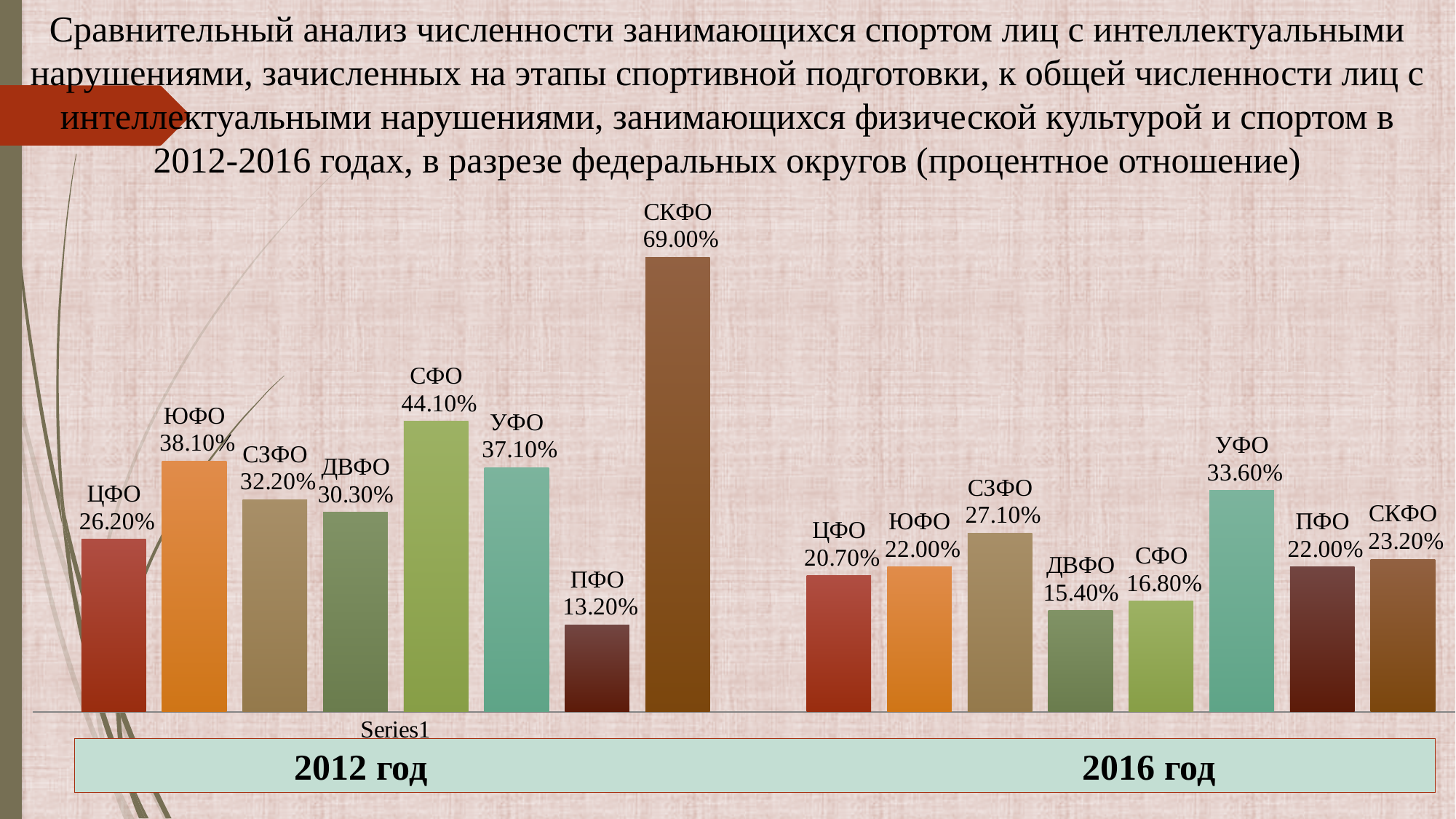
Which federal district has the lowest value in 2016? ДВФО Which federal district has the highest value in 2012? СКФО Which federal district has the lowest value in 2012? ПФО What kind of chart is shown on the slide? Bar chart Which is larger: the value for ЮФО in 2012 or the value for ЮФО in 2016? ЮФО in 2012 What is the value for СКФО in 2012? 69.00% What is the value for ПФО in 2012? 13.20% How many federal districts are shown for the year 2016? 8 What is the value for ДВФО in 2016? 15.40% What is the difference between the СКФО value in 2012 and the СКФО value in 2016? 45.80% What is the value for УФО in 2016? 33.60% What is the difference between the СФО value in 2012 and the СФО value in 2016? 27.30%